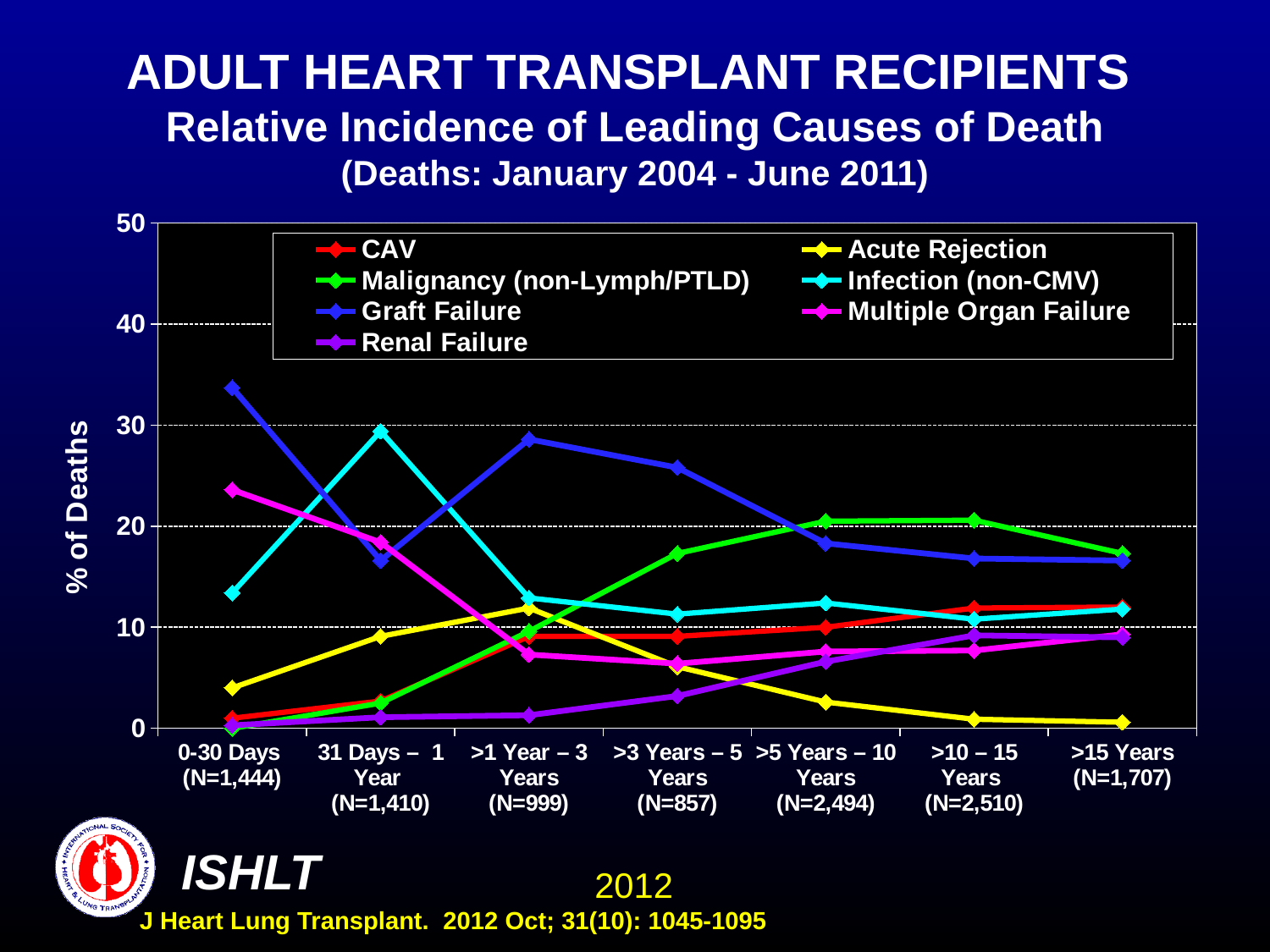
Is the value for Acute Rejection in the >15 Years period greater or less than 10? less Which cause of death has the lowest % of deaths in the >15 Years period? Acute Rejection Which cause of death has the highest % of deaths in the 0-30 Days period? Graft Failure How many time-period categories are shown on the x axis? 7 Is the value for Multiple Organ Failure in the 0-30 Days period greater or less than 20? greater Does the Malignancy (non-Lymph/PTLD) line rise or fall from 0-30 Days to >5 Years – 10 Years? rise In the >3 Years – 5 Years period, which is larger: Graft Failure or Malignancy (non-Lymph/PTLD)? Graft Failure Is the value for Graft Failure in the 0-30 Days period greater or less than 30? greater What is the label on the y axis? % of Deaths Which cause of death has the highest % of deaths in the 31 Days – 1 Year period? Infection (non-CMV) How many series does the legend list? 7 What kind of chart is shown on the slide? line chart